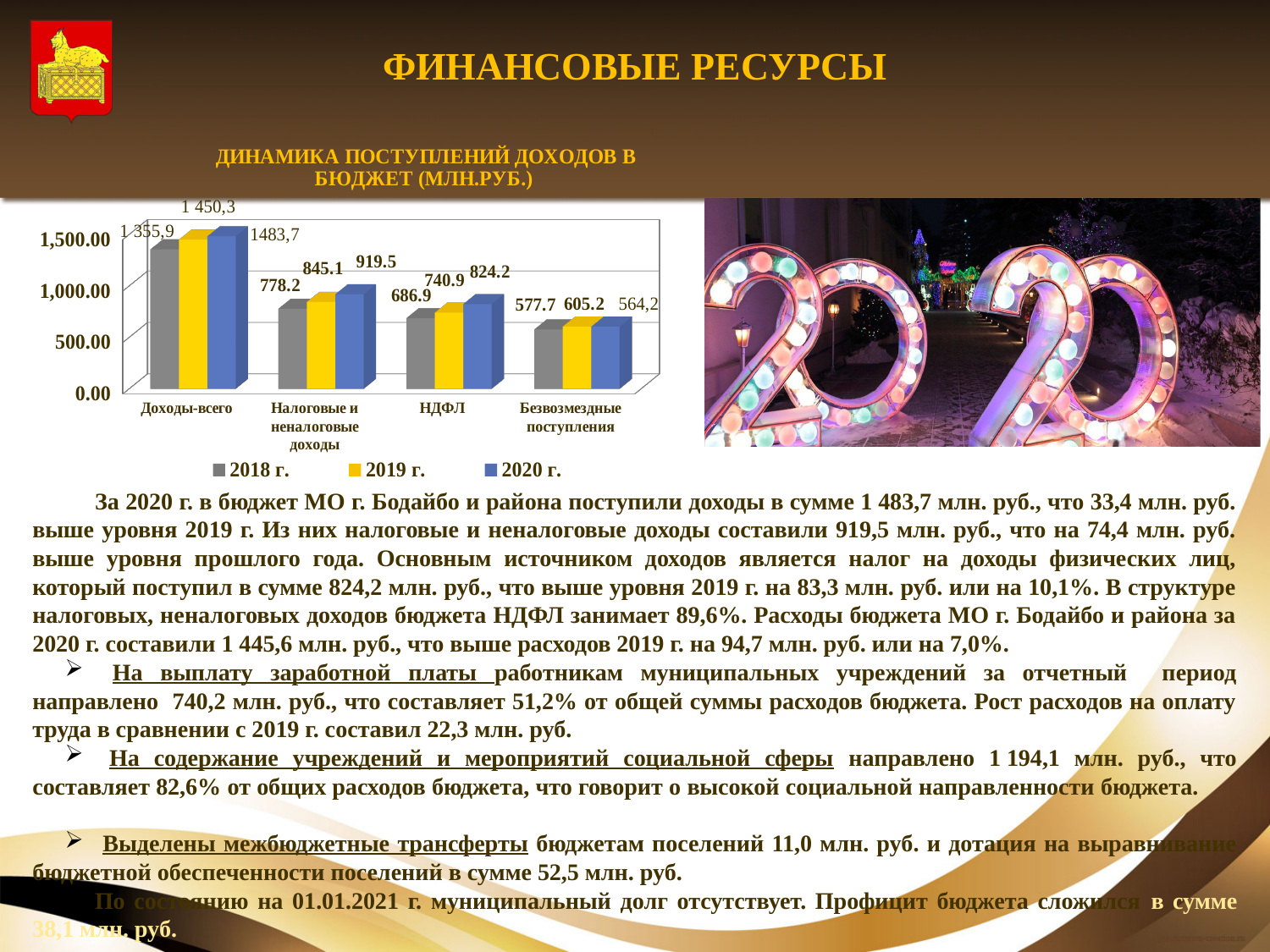
Which category has the highest value for 2020 г.? Доходы-всего Which category has the lowest value for 2018 г.? Безвозмездные поступления What is the value for 2018 г. in the НДФЛ category? 686.9 How many categories are shown on the x axis of the chart? 4 What is the value for 2019 г. in the Налоговые и неналоговые доходы category? 845.1 What is the difference between the 2020 г. and 2019 г. values for НДФЛ? 83.3 What is the value for 2020 г. in the Доходы-всего category? 1483,7 What is the value for 2019 г. in the Безвозмездные поступления category? 605.2 What kind of chart is shown on the slide? bar chart How many series does the chart legend list? 3 Is the value for 2018 г. in the Налоговые и неналоговые доходы category greater or less than 1,000.00? less Which is larger for Безвозмездные поступления: the 2019 г. value or the 2020 г. value? 2019 г.